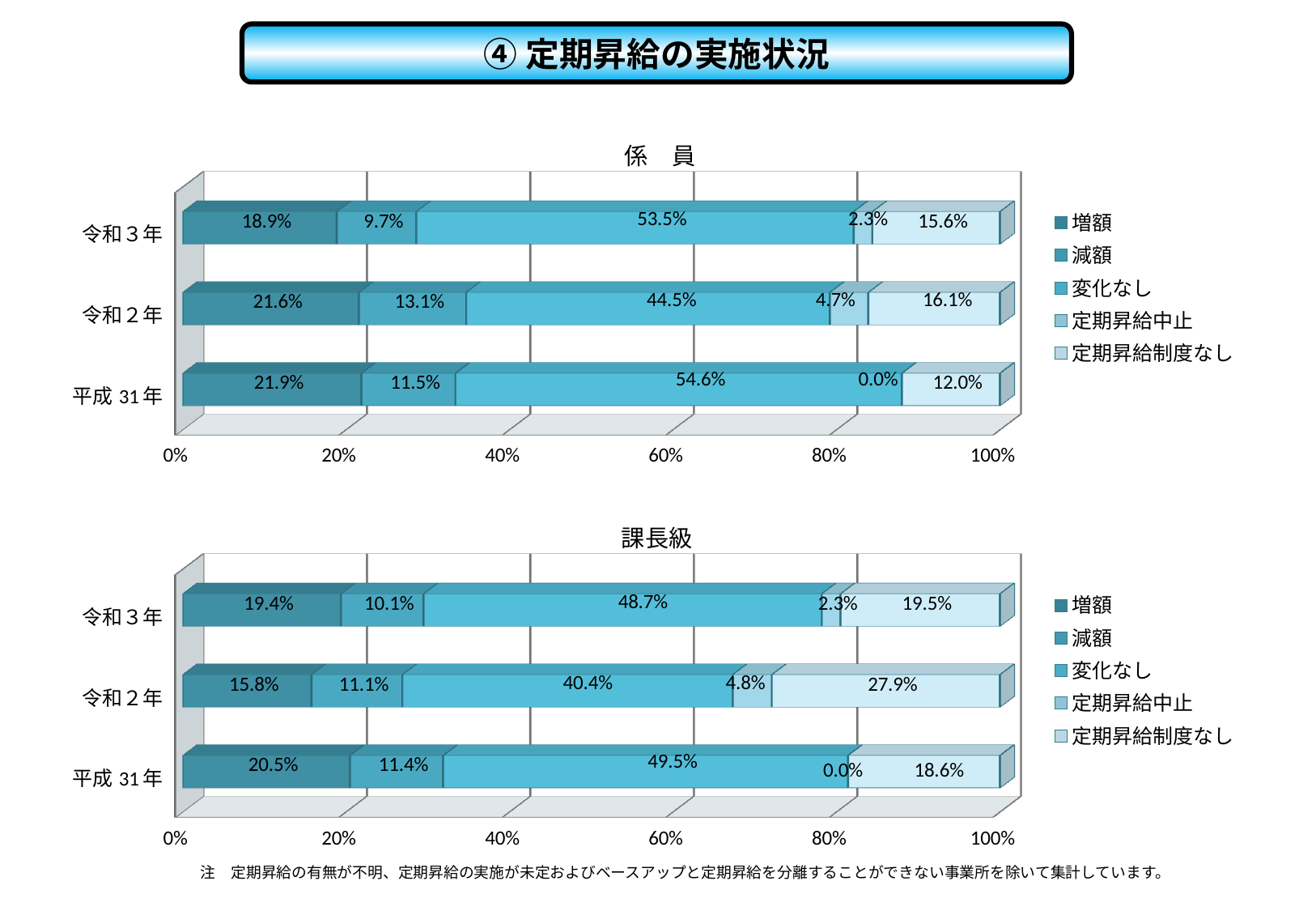
In the 課長級 chart, what is the value for 定期昇給制度なし in 令和２年? 27.9% In the 係員 chart, which year has the highest value for 変化なし? 平成 31年 What kind of chart is the 課長級 chart? Stacked bar chart In the 課長級 chart, which is larger: 定期昇給制度なし in 令和２年 or in 平成 31年? 令和２年 How many years are shown in the 課長級 chart? 3 In the 課長級 chart, what is the value for 減額 in 令和３年? 10.1% In the 係員 chart, what is the value for 増額 in 平成 31年? 21.9% In the 課長級 chart, which year has the lowest value for 増額? 令和２年 In the 係員 chart, what is the value for 変化なし in 令和３年? 53.5% How many series does the legend of the 係員 chart list? 5 In the 係員 chart, what is the difference between the 増額 values for 令和２年 and 令和３年? 2.7% In the 係員 chart, what is the value for 定期昇給中止 in 平成 31年? 0.0%